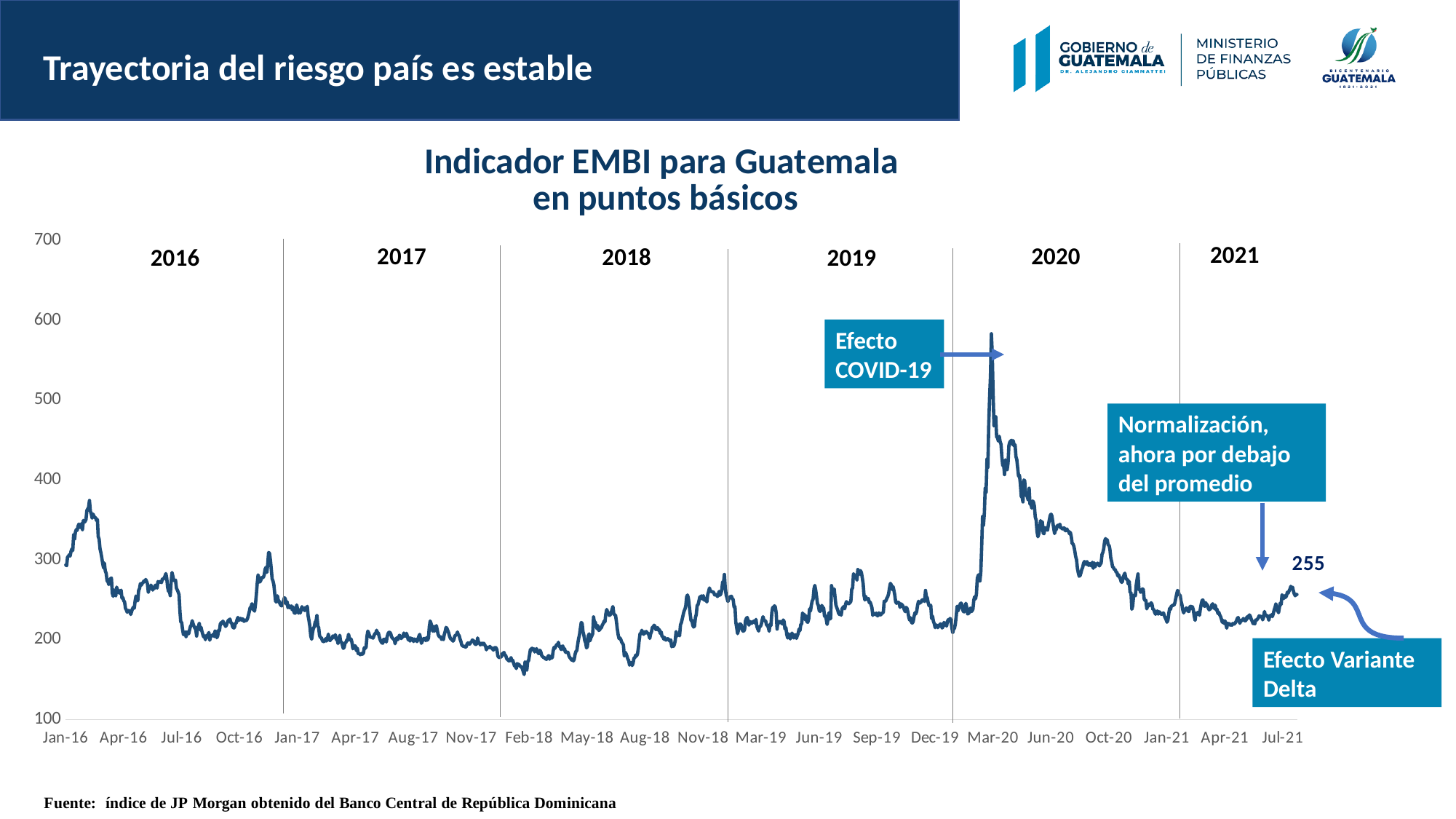
What is the value of the EMBI indicator labelled at the end of the series (Jul-21)? 255 How many year labels are shown across the top of the chart? 6 Which event does the annotation pointing to the 2020 spike attribute it to? Efecto COVID-19 In which year does the EMBI indicator reach its highest peak? 2020 Is the peak of the EMBI indicator in early 2020 greater or less than 500? greater Does the EMBI indicator rise or fall between Mar-20 and Jan-21? fall What kind of chart is shown on the slide? line chart Is the final labelled value of 255 greater or less than 300? less Is the value at Jan-16 greater or less than 200? greater What is the title of the chart? Indicador EMBI para Guatemala en puntos básicos